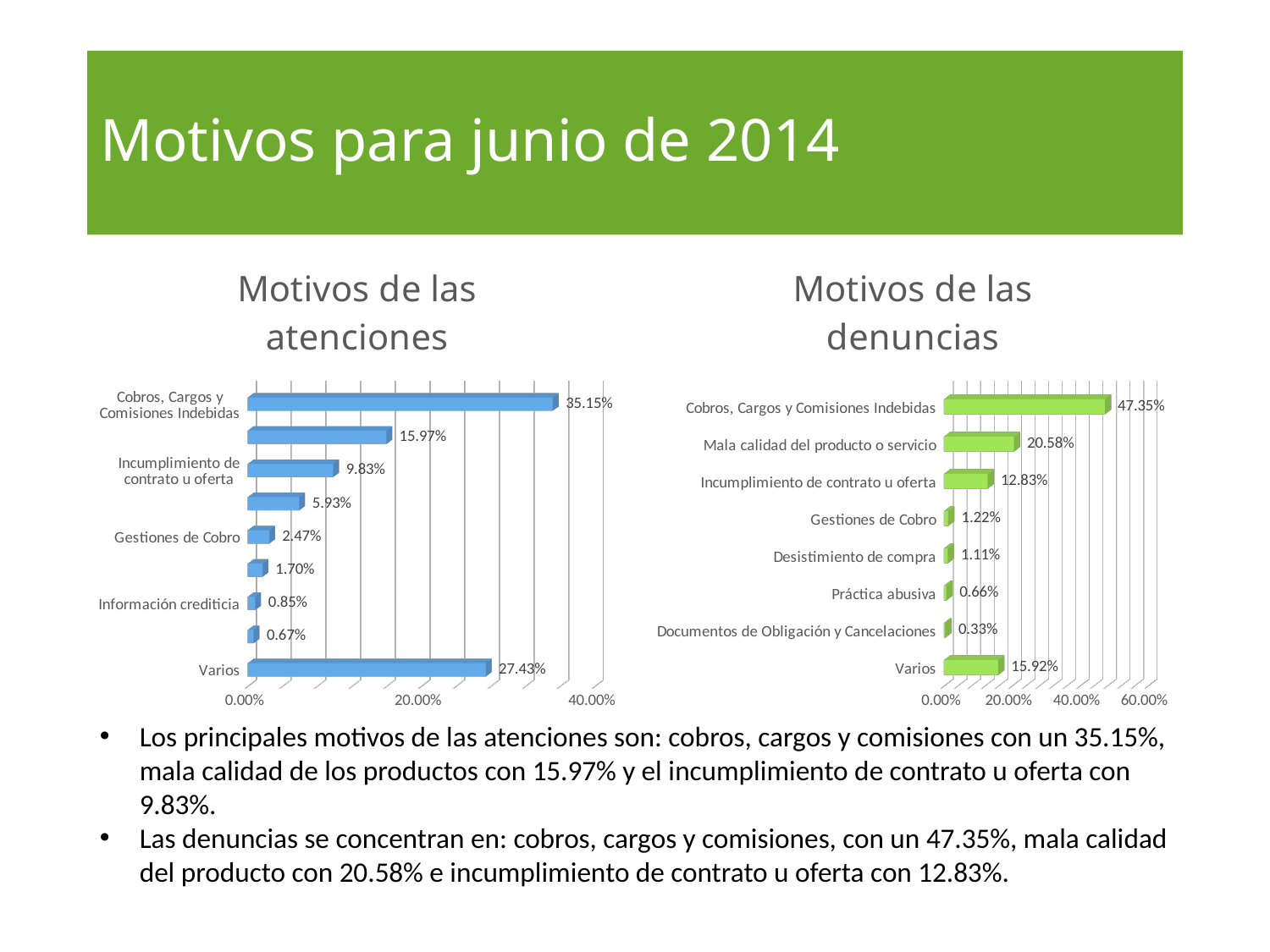
In the 'Motivos de las atenciones' chart, what is the value for Cobros, Cargos y Comisiones Indebidas? 35.15% In the 'Motivos de las atenciones' chart, which labelled category has the highest value? Cobros, Cargos y Comisiones Indebidas In the 'Motivos de las denuncias' chart, which category has the lowest value? Documentos de Obligación y Cancelaciones In the 'Motivos de las denuncias' chart, what is the difference between Cobros, Cargos y Comisiones Indebidas and Mala calidad del producto o servicio? 26.77% In the 'Motivos de las atenciones' chart, what is the value for Varios? 27.43% In the 'Motivos de las atenciones' chart, what is the value for Gestiones de Cobro? 2.47% What type of chart is 'Motivos de las atenciones'? Bar chart How many bars are shown in the 'Motivos de las denuncias' chart? 8 In the 'Motivos de las denuncias' chart, what is the value for Documentos de Obligación y Cancelaciones? 0.33% In the 'Motivos de las denuncias' chart, what is the value for Mala calidad del producto o servicio? 20.58% What colour are the bars in the 'Motivos de las denuncias' chart? Green In the 'Motivos de las denuncias' chart, which is larger: Varios or Incumplimiento de contrato u oferta? Varios